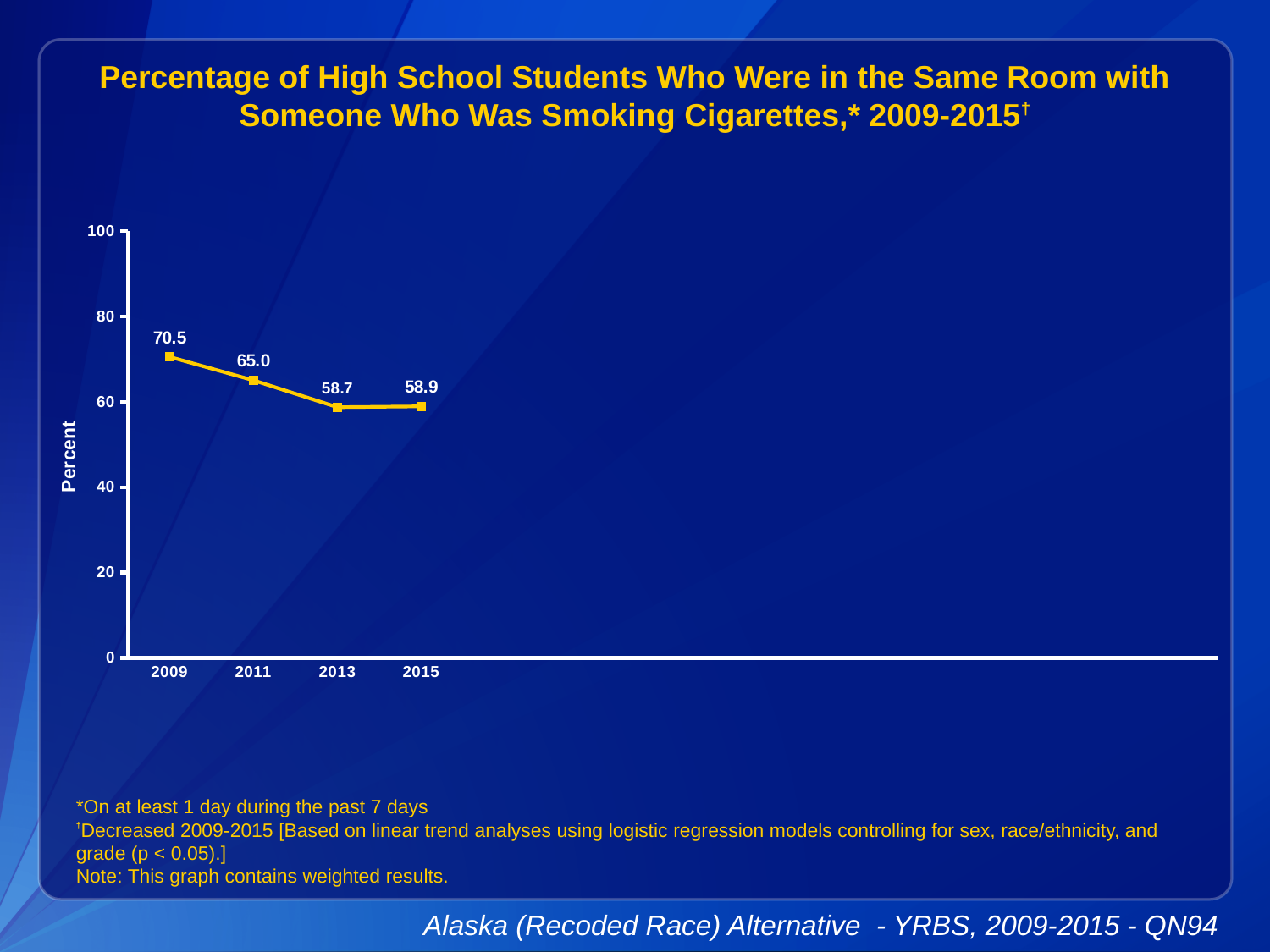
What was the percentage of high school students who were in the same room with someone smoking cigarettes in 2009? 70.5 What value is shown for 2015? 58.9 Which year has the lowest value? 2013 Which is larger, the value for 2009 or the value for 2011? 2009 Which year has the highest value? 2009 What is the difference between the 2009 value and the 2011 value? 5.5 What value is shown for 2013? 58.7 Is the value for 2011 greater or less than 60? greater What is the label on the y axis? Percent What kind of chart is shown on the slide? line chart What is the difference between the 2011 value and the 2015 value? 6.1 How many years are plotted on the chart? 4